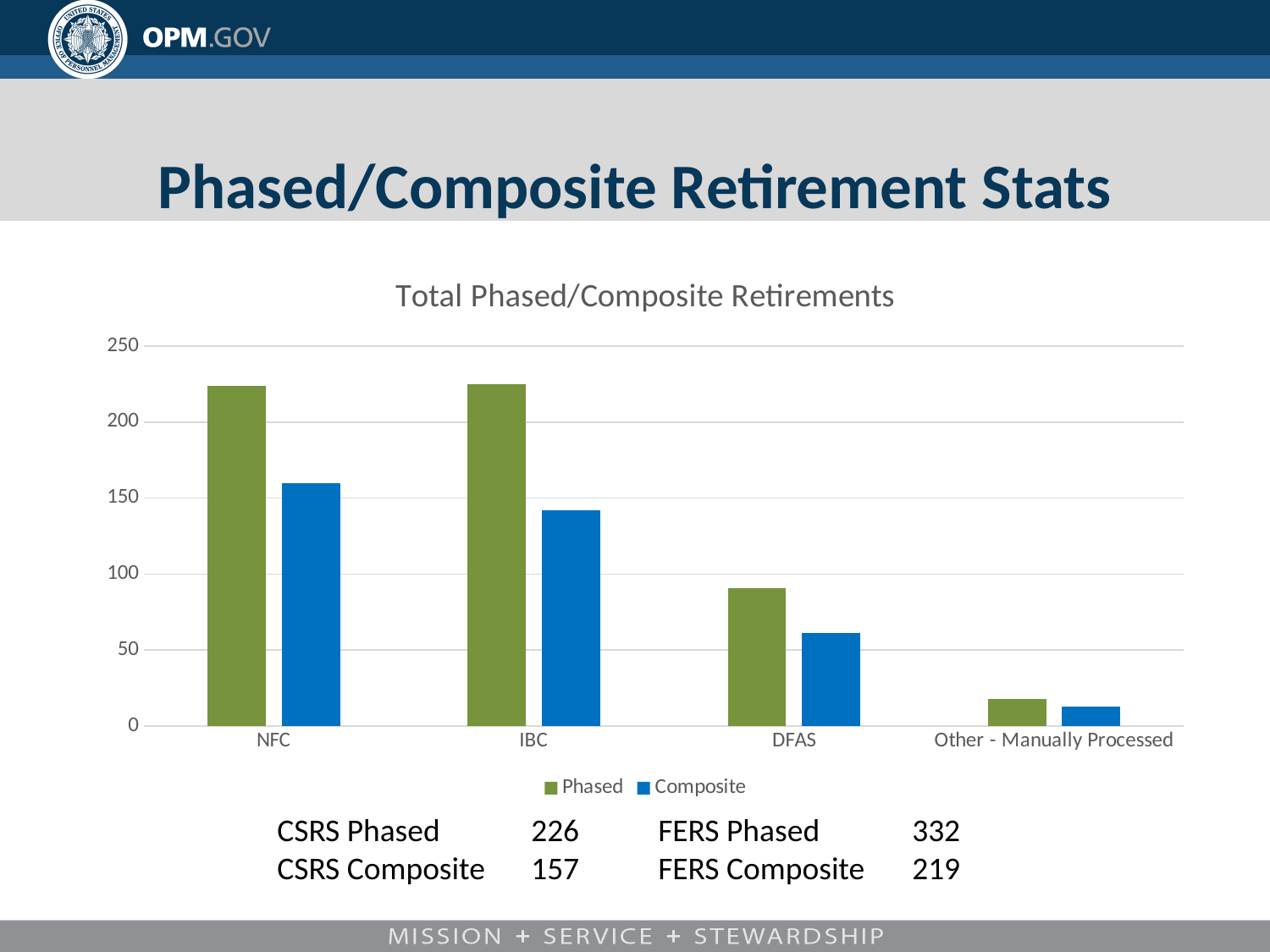
Is the Composite value for IBC greater or less than 150? less Do the Composite values rise or fall moving from NFC to Other - Manually Processed along the x axis? fall Which category has the highest Composite value? NFC What type of chart is shown on the slide? bar chart Is the Composite value for DFAS greater or less than 50? greater Which category has the lowest Phased value? Other - Manually Processed How many categories are shown on the x axis? 4 Is the Phased value for DFAS greater or less than 100? less How many series does the legend list? 2 What is the title of the chart? Total Phased/Composite Retirements Which is larger, the Composite value for NFC or the Composite value for IBC? NFC